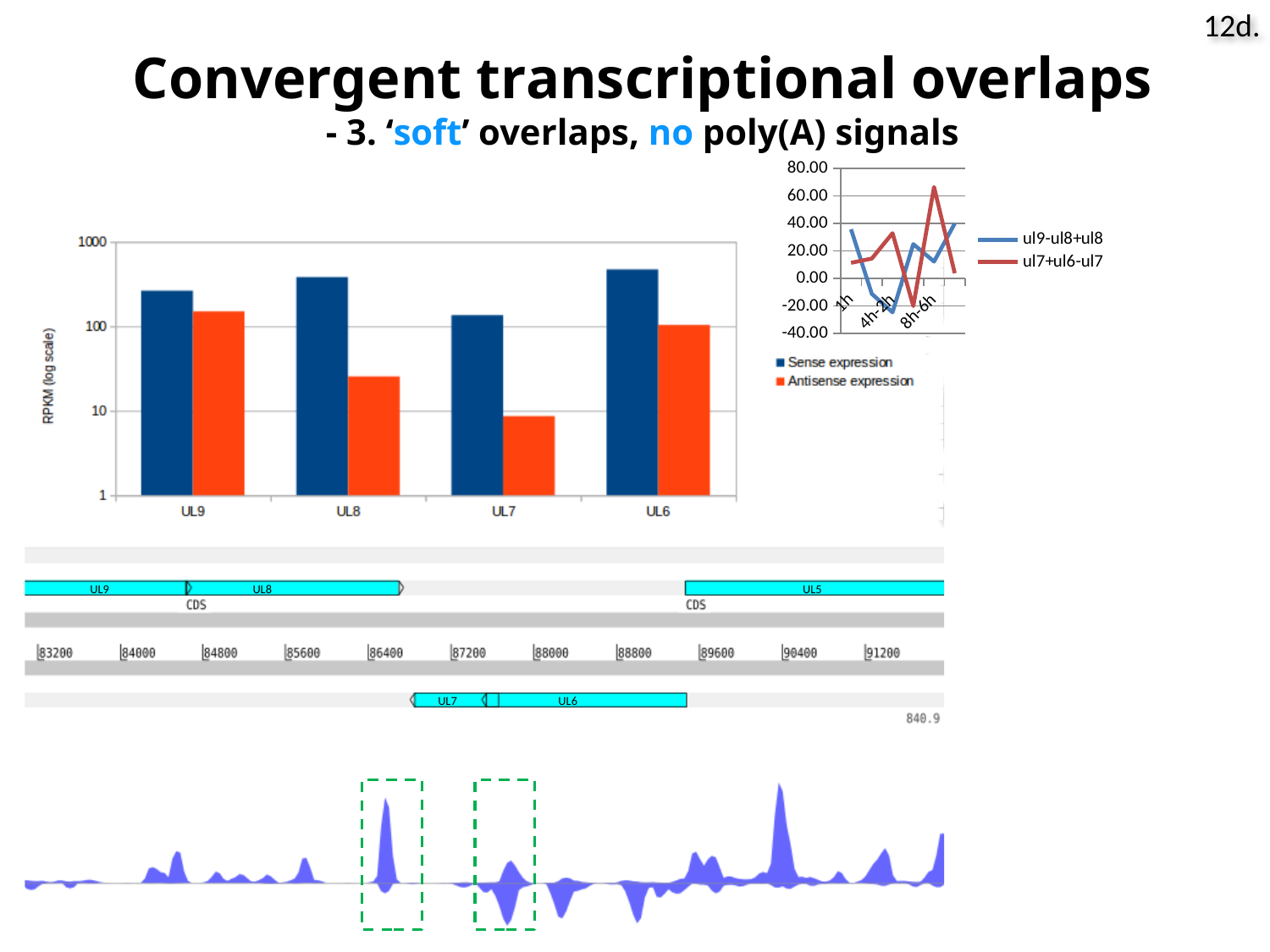
In the RPKM (log scale) bar chart, is the Antisense expression for UL8 greater or less than 100? less In the RPKM (log scale) bar chart, which is larger for UL8: Sense expression or Antisense expression? Sense expression How many categories are shown on the x axis of the RPKM (log scale) bar chart? 4 In the RPKM (log scale) bar chart, which category has the highest Sense expression? UL6 What kind of chart is the RPKM (log scale) chart on the left of the slide? bar chart In the RPKM (log scale) bar chart, is the Sense expression for UL9 greater or less than 100? greater In the RPKM (log scale) bar chart, which category has the highest Antisense expression? UL9 How many series does the legend of the line chart in the top right of the slide list? 2 How many series does the legend of the RPKM (log scale) bar chart list? 2 In the RPKM (log scale) bar chart, which category has the lowest Antisense expression? UL7 In the RPKM (log scale) bar chart, which category has the lowest Sense expression? UL7